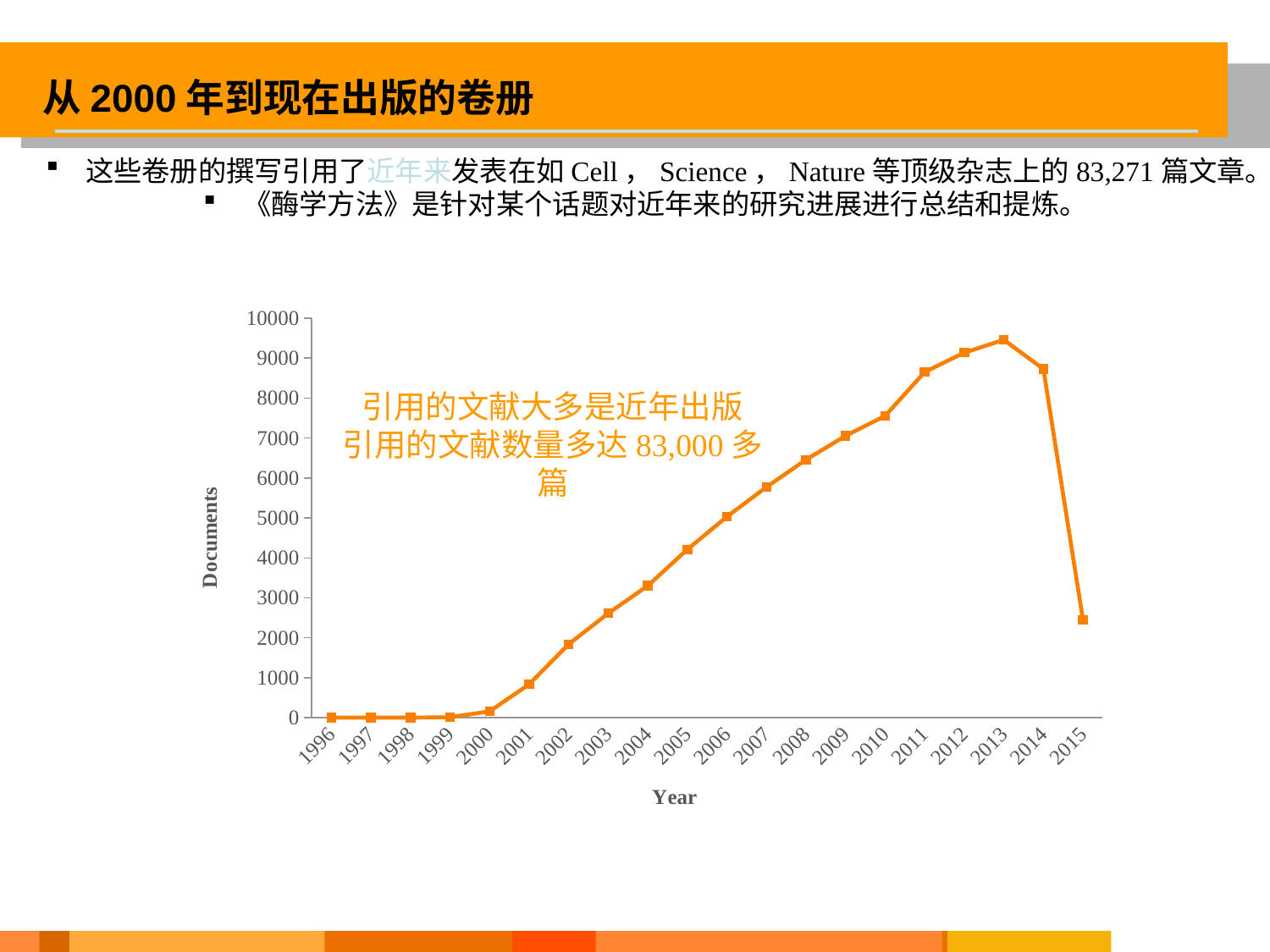
Is the value for 2015 greater or less than 3000? less Is the value for 2006 greater or less than 4000? greater Is the value for 2010 greater or less than 7000? greater What kind of chart is shown on the slide? line chart Which year has more documents, 2014 or 2015? 2014 Which year has the highest number of documents? 2013 Do the values rise or fall from 2000 to 2013? rise How many years are plotted along the x axis? 20 Which year has more documents, 2005 or 2011? 2011 What is the label of the y axis? Documents